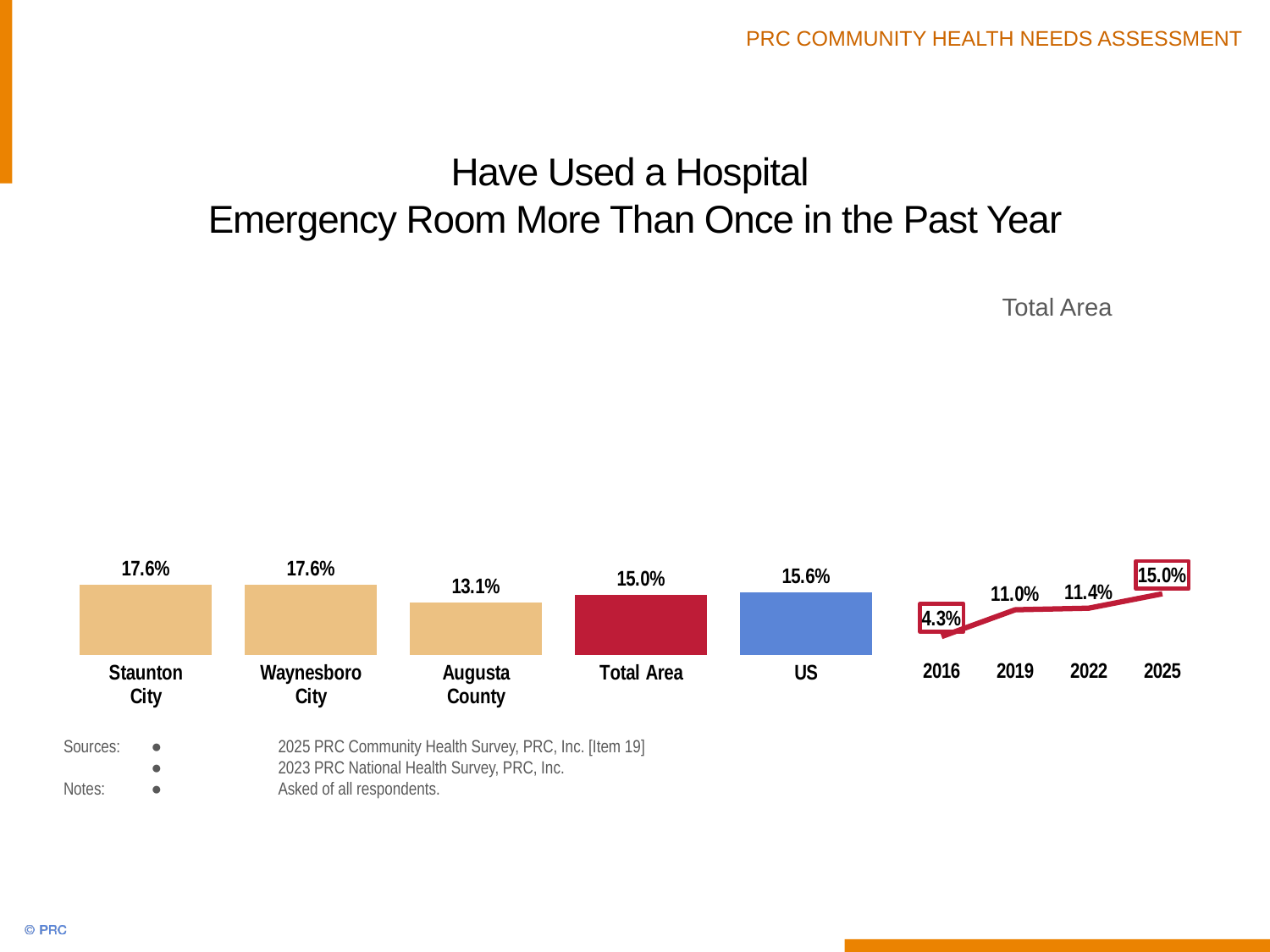
In the bar chart on the left, which is larger, the value for Augusta County or the value for Total Area? Total Area In the bar chart on the left, what is the difference between Staunton City and Augusta County? 4.5% In the bar chart on the left, what is the difference between the US value and the Total Area value? 0.6% In the Total Area trend chart on the right, what is the difference between the 2025 value and the 2016 value? 10.7% What kind of chart is the chart on the right showing Total Area over time? line chart In the Total Area trend chart on the right, what is the value for 2022? 11.4% In the Total Area trend chart on the right, do the values rise or fall from 2016 to 2025? rise In the bar chart on the left, how many categories are shown? 5 In the bar chart on the left, what is the value for Augusta County? 13.1% In the bar chart on the left, what is the value for the US? 15.6% In the bar chart on the left, which category has the lowest value? Augusta County In the Total Area trend chart on the right, what is the value for 2016? 4.3%